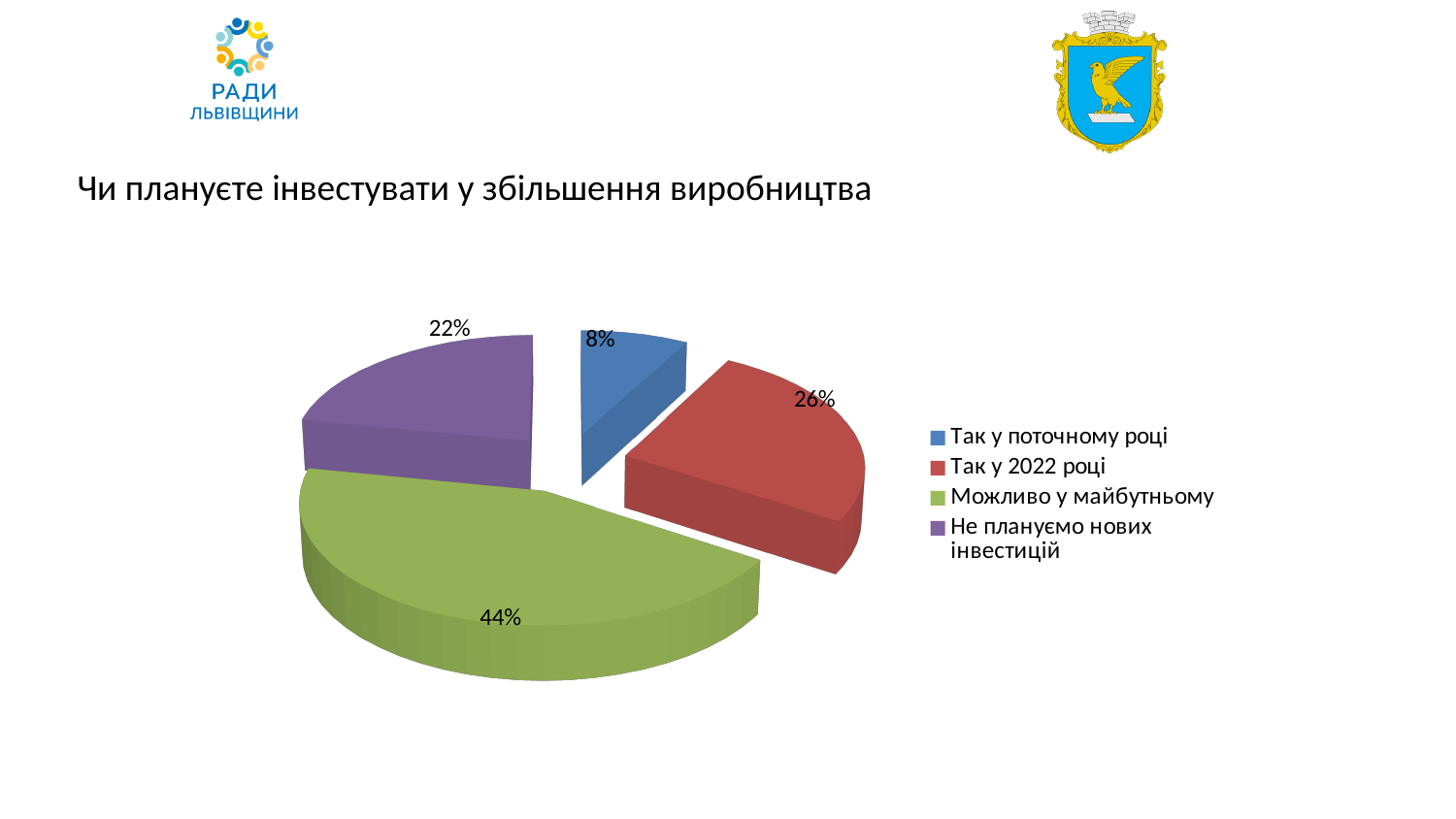
What kind of chart is shown on the slide? Pie chart Which category has the smallest slice of the pie? Так у поточному році What share of the pie does "Можливо у майбутньому" represent? 44% Which category has the largest slice of the pie? Можливо у майбутньому What share of the pie does "Не плануємо нових інвестицій" represent? 22% How many categories does the pie chart show? 4 What colour is the slice for "Не плануємо нових інвестицій"? Purple What share of the pie does "Так у 2022 році" represent? 26% Which is larger: the slice for "Так у 2022 році" or the slice for "Не плануємо нових інвестицій"? Так у 2022 році What is the title of the chart on the slide? Чи плануєте інвестувати у збільшення виробництва What is the difference in percentage points between "Можливо у майбутньому" and "Так у 2022 році"? 18